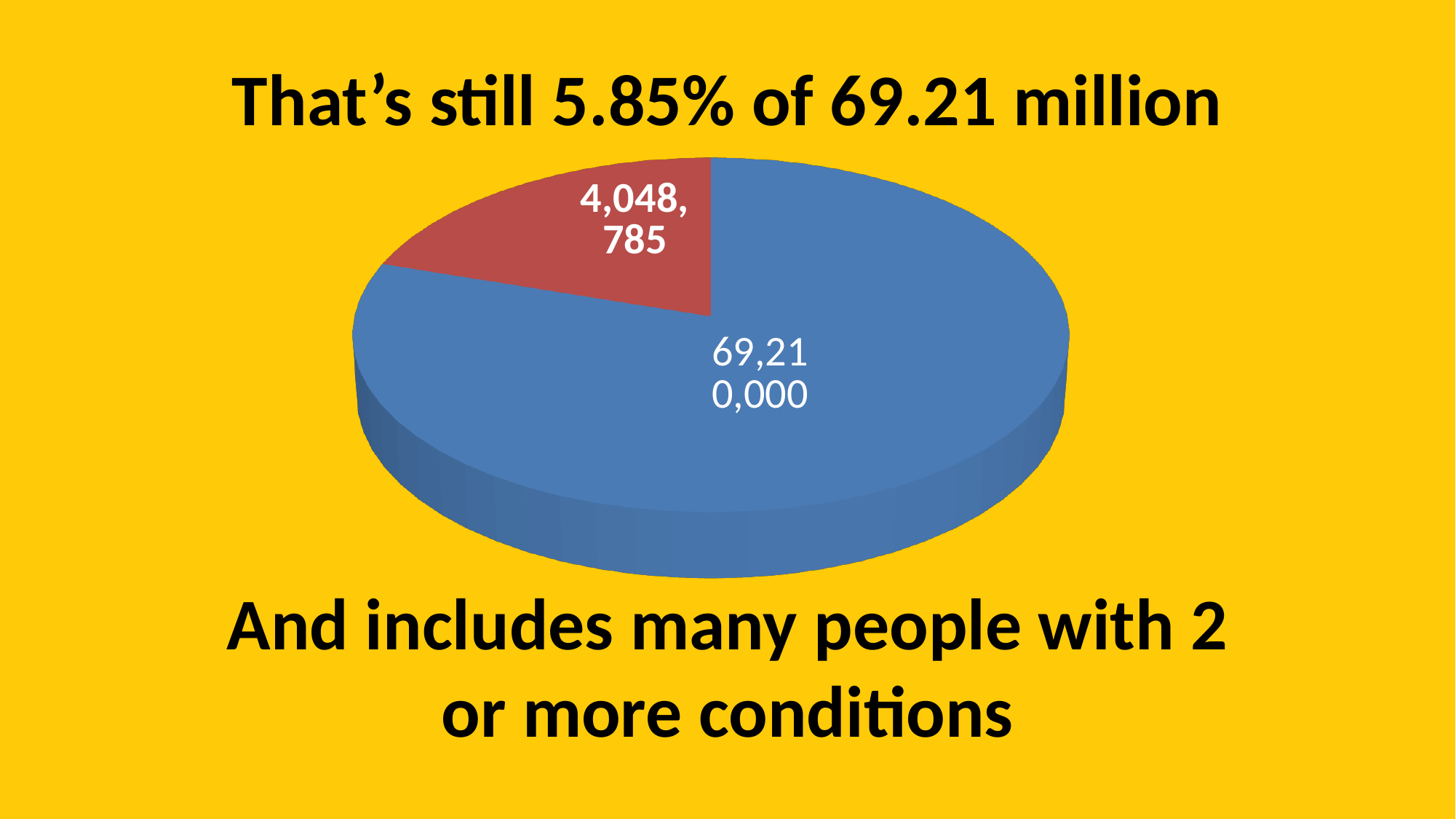
What does the text above the pie chart say? That's still 5.85% of 69.21 million What is the difference between the blue slice value and the red slice value? 65,161,215 Which is larger, the red slice or the blue slice? The blue slice What value is labelled on the blue slice of the pie chart? 69,210,000 What value is labelled on the red slice of the pie chart? 4,048,785 Which slice of the pie chart is the largest? The blue slice (69,210,000) What kind of chart is shown on the slide? Pie chart What is the total of the two values shown in the pie chart? 73,258,785 What colour is the slice labelled 4,048,785? Red Which slice of the pie chart is the smallest? The red slice (4,048,785) How many slices does the pie chart have? 2